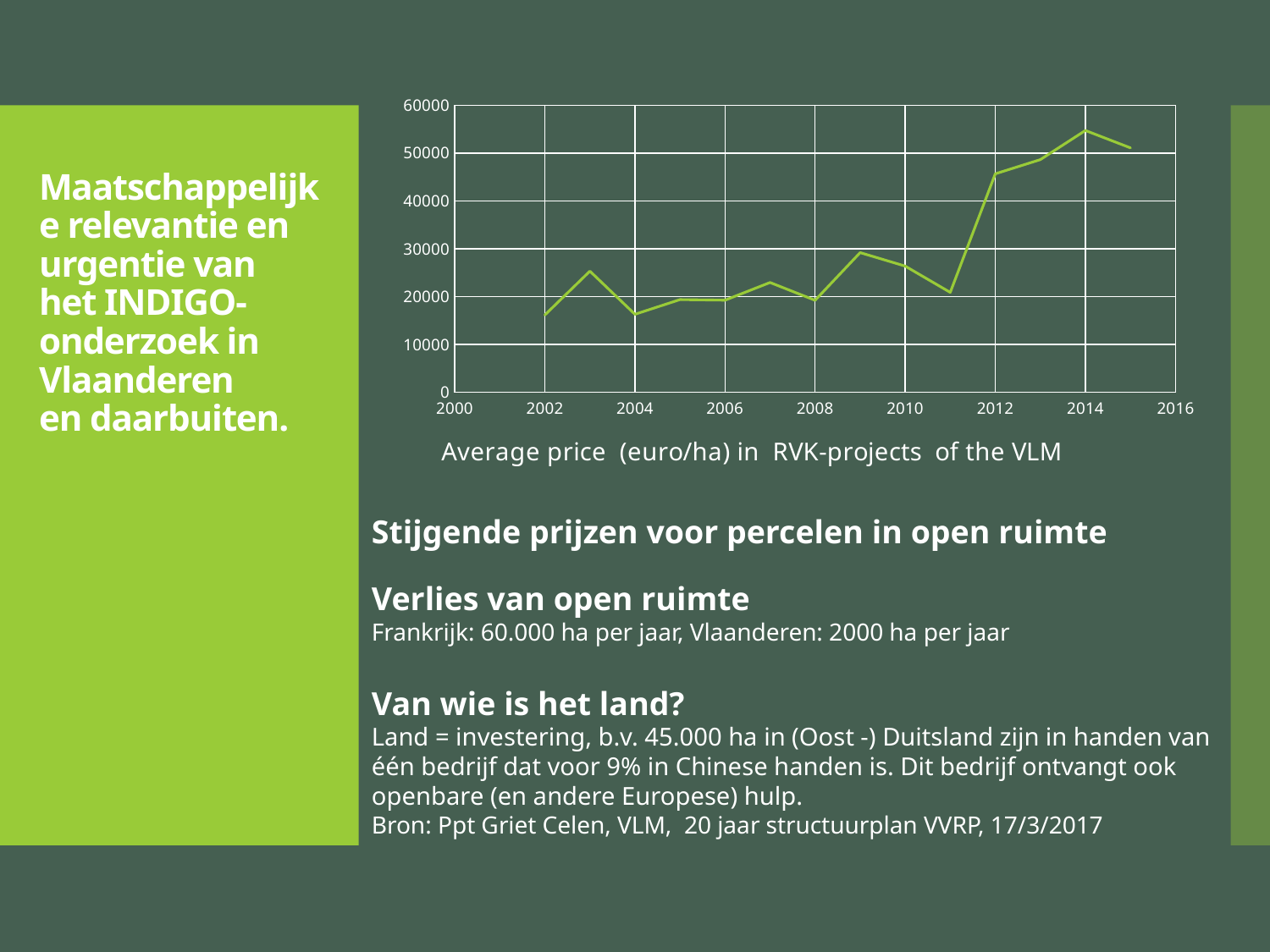
Is the value for 2002 greater or less than 20000? less Is the value for 2011 greater or less than 30000? less Is the value for 2014 greater or less than 50000? greater What kind of chart is shown on the slide? line chart Which year has the larger value, 2011 or 2012? 2012 Does the line rise or fall between 2011 and 2014? rise In which year does the line reach its highest value? 2014 Does the line rise or fall between 2014 and 2015? fall What is the caption printed below the chart? Average price (euro/ha) in RVK-projects of the VLM Which year has the larger value, 2003 or 2004? 2003